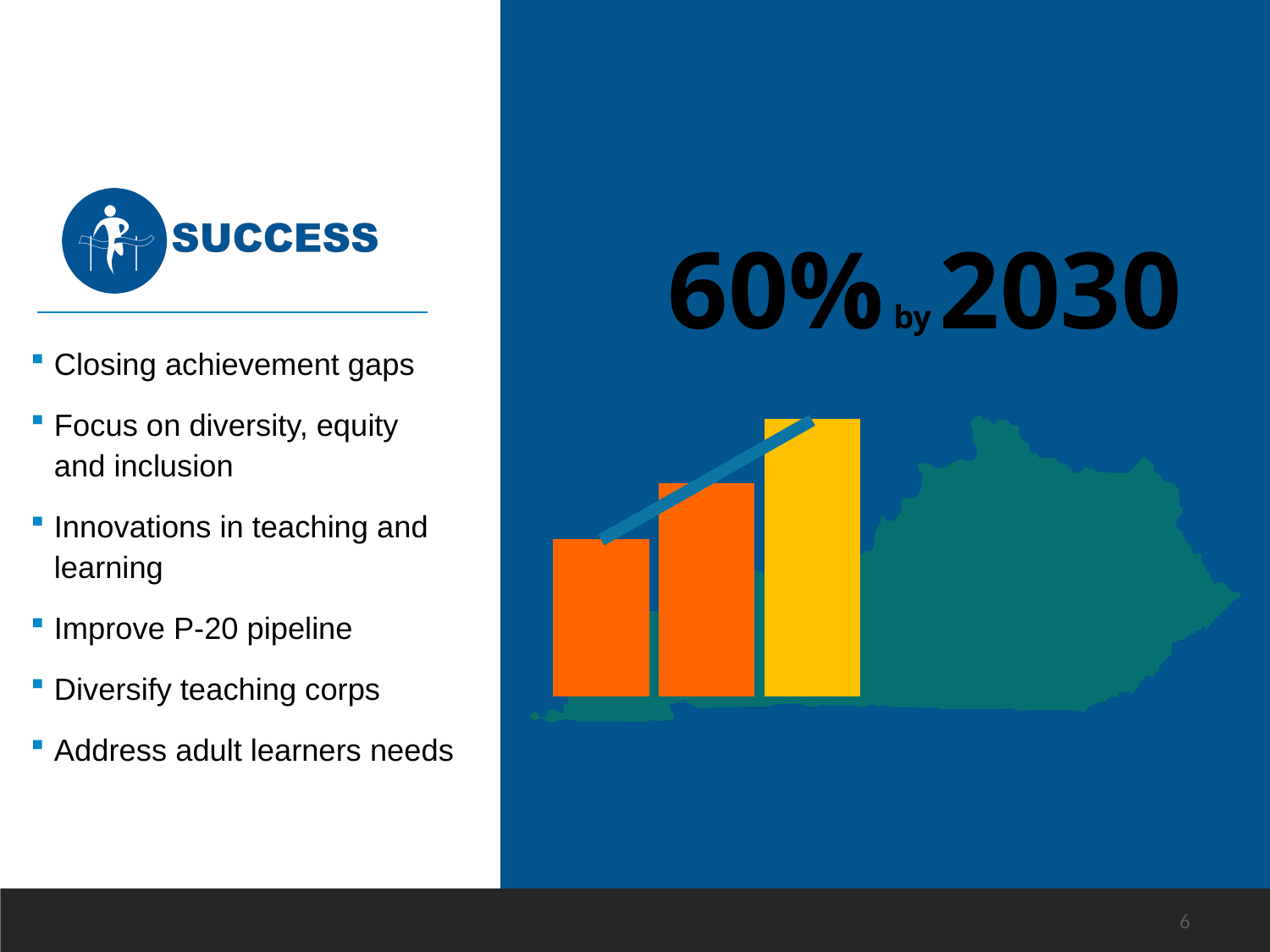
What colour is the tallest bar in the chart on the right side of the slide? yellow How many bars does the chart on the right side of the slide have? 3 Do the bars in the chart on the right side of the slide rise or fall from left to right? rise Which bar in the chart on the right side of the slide is the shortest: the left, middle or right bar? left What colour are the two shorter bars in the chart on the right side of the slide? orange What kind of chart is shown on the right side of the slide? bar chart Is the middle bar or the right bar taller in the chart on the right side of the slide? right bar Which bar in the chart on the right side of the slide is the tallest: the left, middle or right bar? right